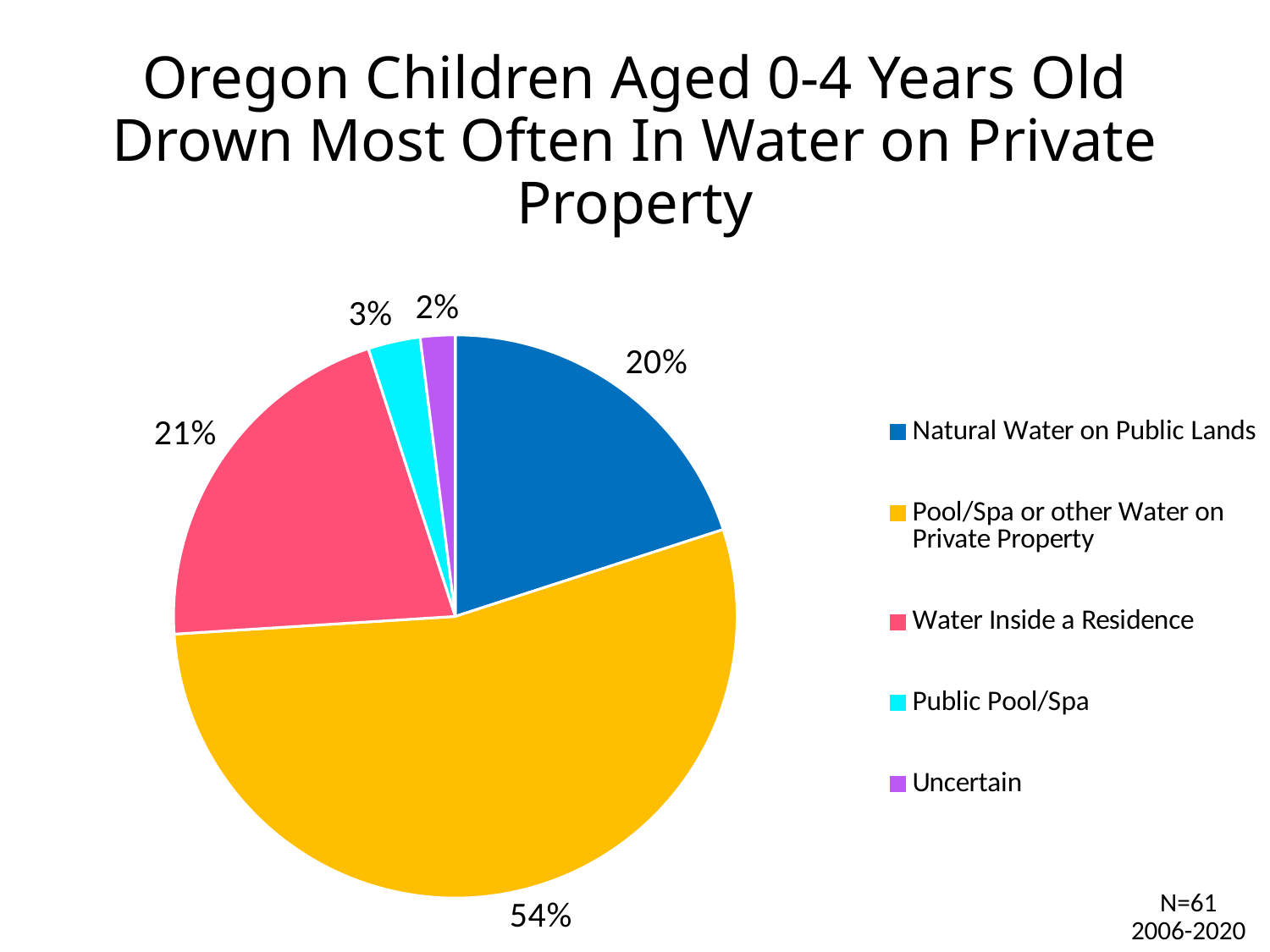
What is the difference in percentage points between Pool/Spa or other Water on Private Property and Water Inside a Residence? 33 What percentage is shown for Public Pool/Spa? 3% Which category has the smallest share of the pie? Uncertain What type of chart is shown on the slide? Pie chart Which category has the largest share of the pie? Pool/Spa or other Water on Private Property What percentage is shown for Uncertain? 2% Which is larger: the share for Natural Water on Public Lands or the share for Public Pool/Spa? Natural Water on Public Lands What percentage is shown for Natural Water on Public Lands? 20% How many categories does the legend list? 5 What share of drownings is attributed to Pool/Spa or other Water on Private Property? 54% What percentage is shown for Water Inside a Residence? 21% What sample size (N) is noted on the slide? N=61